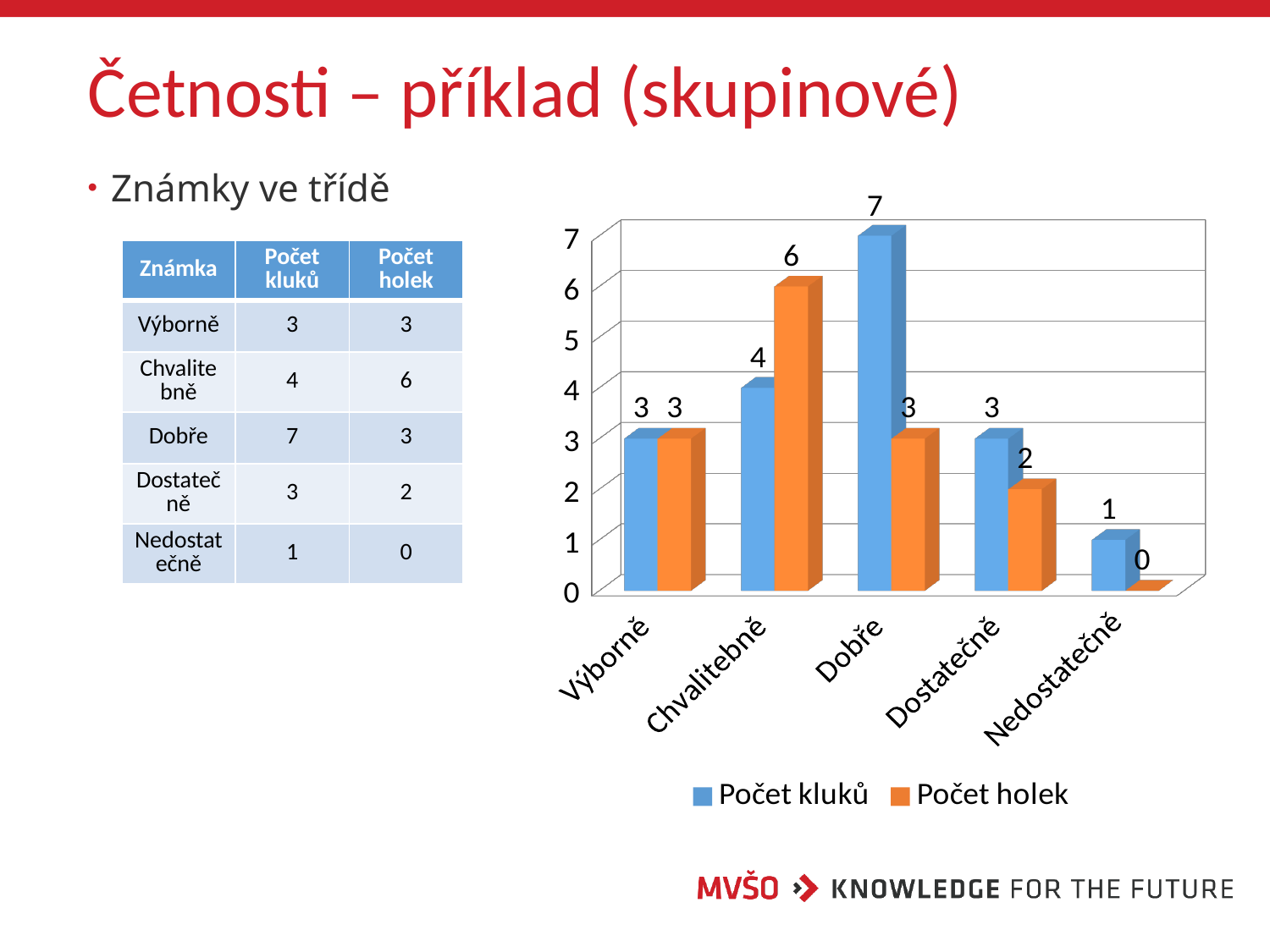
Which colour represents Počet holek in the chart? Orange Which category has the highest value for Počet kluků? Dobře What kind of chart is shown on the slide? Bar chart What is the total of Počet kluků and Počet holek in the Dostatečně category? 5 What is the value for Počet holek in the Nedostatečně category? 0 What is the value for Počet kluků in the Dobře category? 7 How many series does the legend list? 2 What is the value for Počet holek in the Chvalitebně category? 6 Which category has the lowest value for Počet holek? Nedostatečně How many categories are shown on the x axis? 5 Which is larger in the Chvalitebně category, Počet kluků or Počet holek? Počet holek What is the difference between Počet kluků and Počet holek in the Dobře category? 4